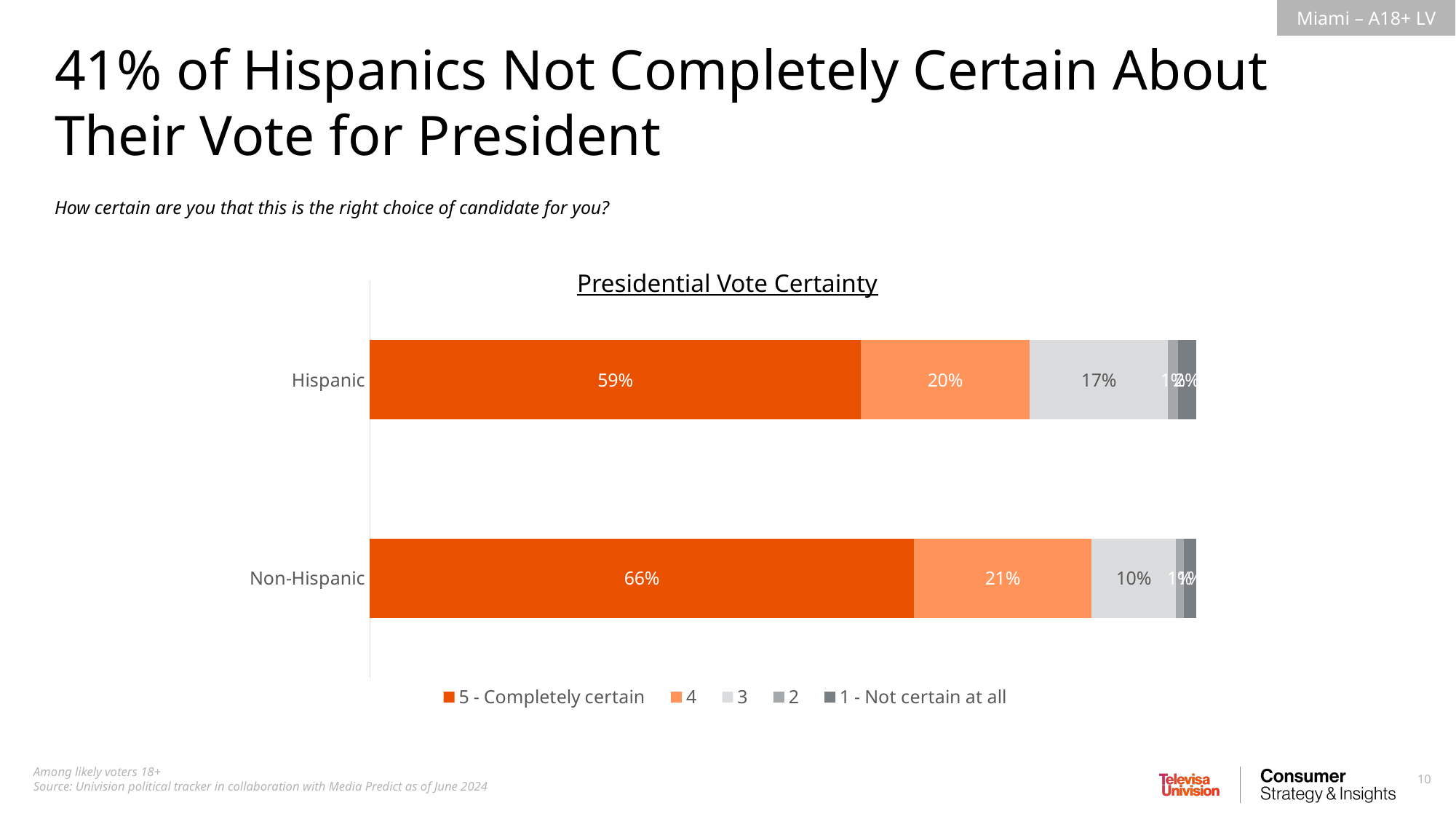
What is the value of the '3' segment for Non-Hispanic voters? 10% How many series does the legend list? 5 How many percentage points higher is the '5 - Completely certain' share for Non-Hispanic voters than for Hispanic voters? 7 percentage points What is the value of the '3' segment for Hispanic voters? 17% How many percentage points higher is the '3' share for Hispanic voters than for Non-Hispanic voters? 7 percentage points What percentage of Non-Hispanic likely voters are '5 - Completely certain' about their presidential vote? 66% Which group has the larger share of '5 - Completely certain' voters, Hispanic or Non-Hispanic? Non-Hispanic What is the value of the '4' segment for Non-Hispanic voters? 21% What percentage of Hispanic likely voters are '5 - Completely certain' about their presidential vote? 59% How many groups (bars) are shown in the chart? 2 What type of chart is used to show Presidential Vote Certainty? Stacked bar chart What is the value of the '4' segment for Hispanic voters? 20%